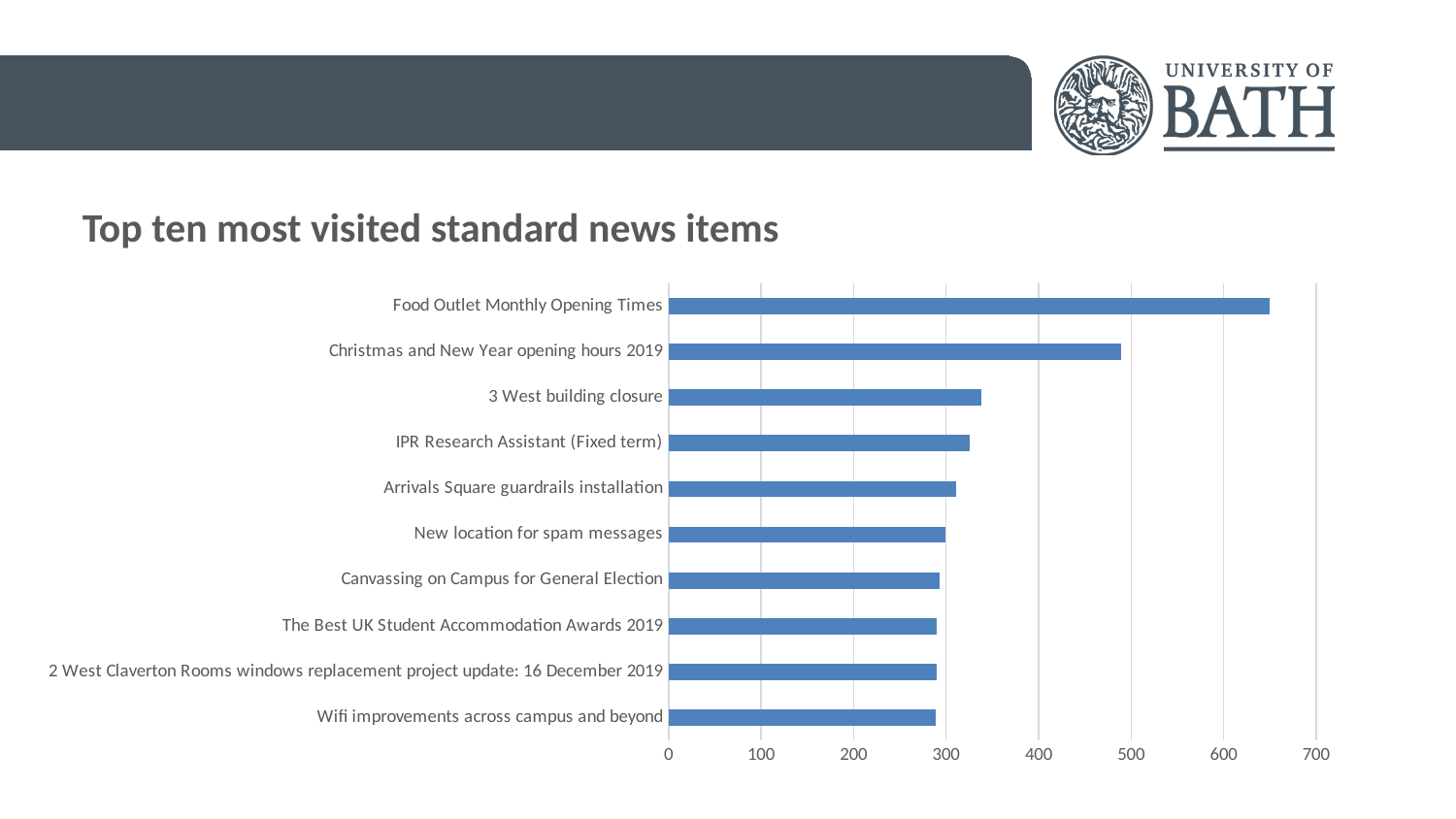
Is the value for 3 West building closure greater or less than 300? greater What type of chart is shown on the slide? Bar chart What is the title of the chart? Top ten most visited standard news items Which news item has the highest number of visits? Food Outlet Monthly Opening Times Is the value for IPR Research Assistant (Fixed term) greater or less than 400? less How many news items are plotted in the chart? 10 Is the value for Food Outlet Monthly Opening Times greater or less than 600? greater Which has more visits: 3 West building closure or Wifi improvements across campus and beyond? 3 West building closure Which has more visits: Food Outlet Monthly Opening Times or Christmas and New Year opening hours 2019? Food Outlet Monthly Opening Times Do the bar values increase or decrease going from the top of the chart to the bottom? decrease